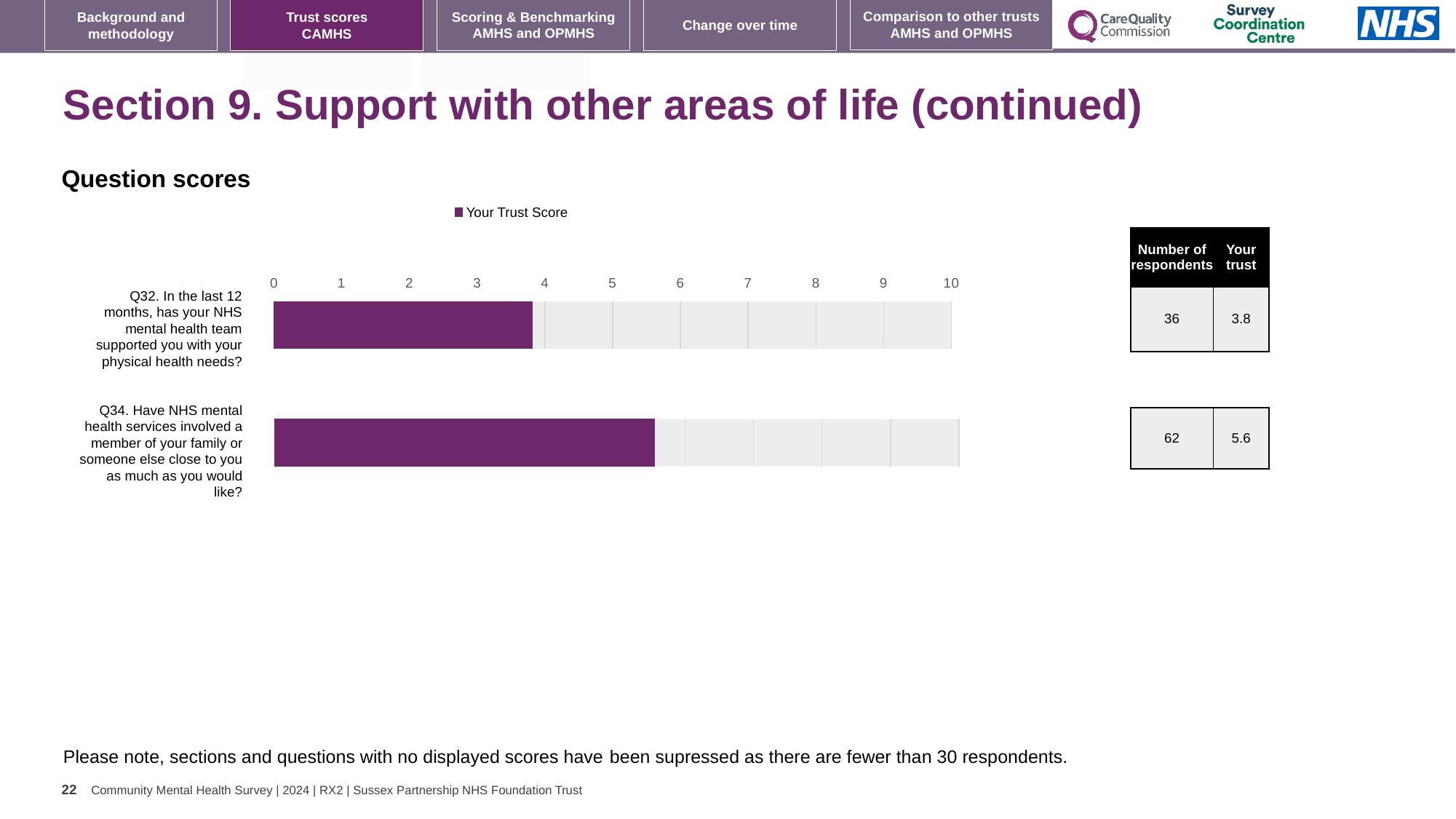
Is the trust score for Q32 greater or less than 4? less Which question has the lowest trust score on the chart? Q32 How many series does the chart legend list? 1 Which question has the higher trust score, Q32 or Q34? Q34 What is the name of the series shown in the chart legend? Your Trust Score Is the trust score for Q34 greater or less than 5? greater What is the difference between the trust scores for Q34 and Q32? 1.8 How many questions are plotted on the chart? 2 How many respondents answered Q34? 62 What kind of chart is shown on the slide? Bar chart What is the Your Trust Score for Q34 (involving family or someone close to you)? 5.6 What is the Your Trust Score for Q32 (support with physical health needs)? 3.8